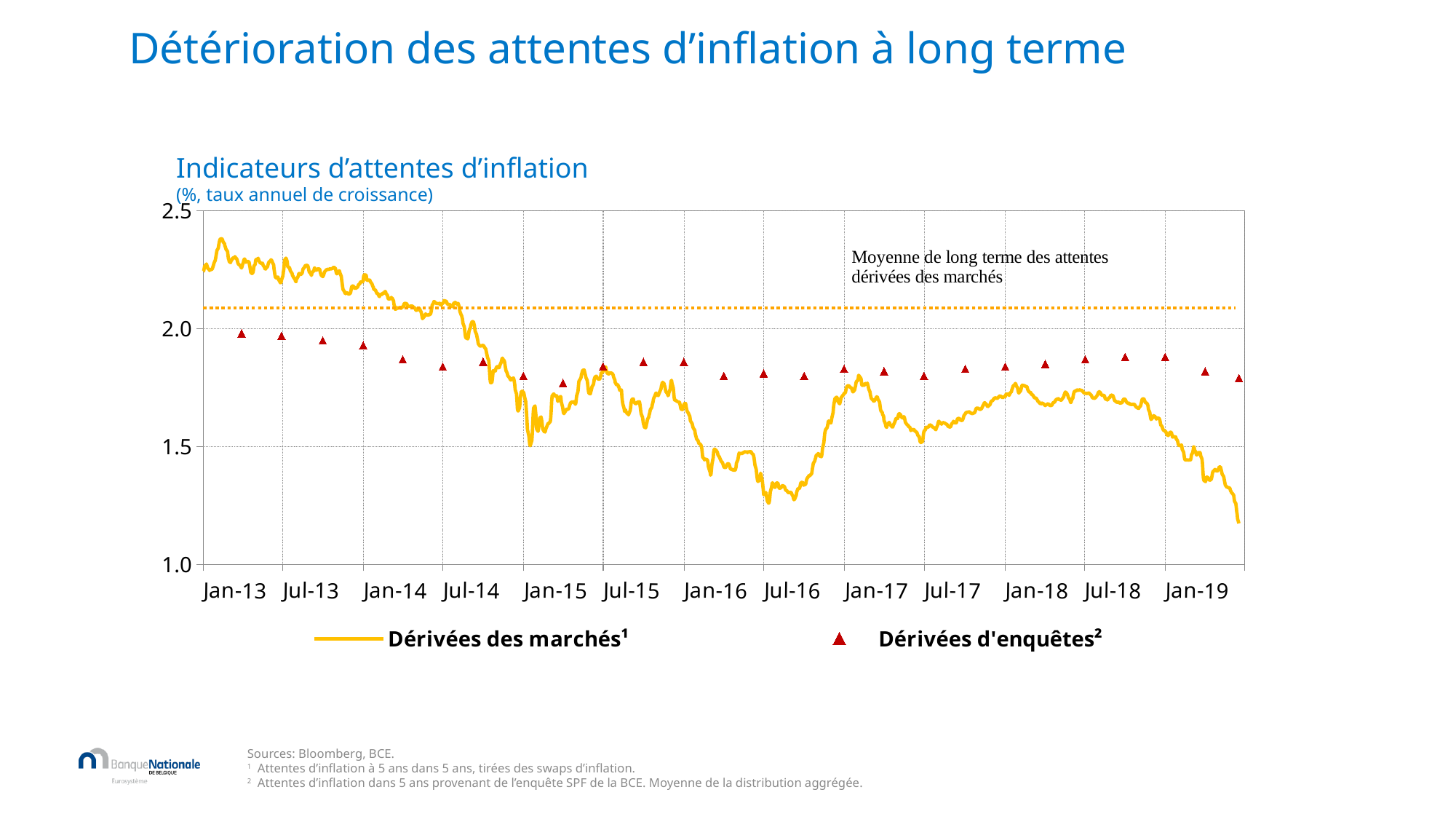
Is the value for Dérivées des marchés at Jan-13 greater or less than 2.0? greater Is the value for Dérivées des marchés around Jul-16 greater or less than 1.5? less In which year does the Dérivées des marchés series reach its lowest value? 2019 Is the value for Dérivées des marchés at the end of the series in 2019 greater or less than 1.5? less What is the title of the chart? Indicateurs d'attentes d'inflation At Jan-13, which series is higher: Dérivées des marchés or Dérivées d'enquêtes? Dérivées des marchés What does the dotted horizontal line represent? Moyenne de long terme des attentes dérivées des marchés How many series does the legend list? 2 At Jan-16, which series is higher: Dérivées des marchés or Dérivées d'enquêtes? Dérivées d'enquêtes What kind of chart is shown on the slide? line chart Does the Dérivées des marchés series rise or fall overall from Jan-13 to 2019? fall